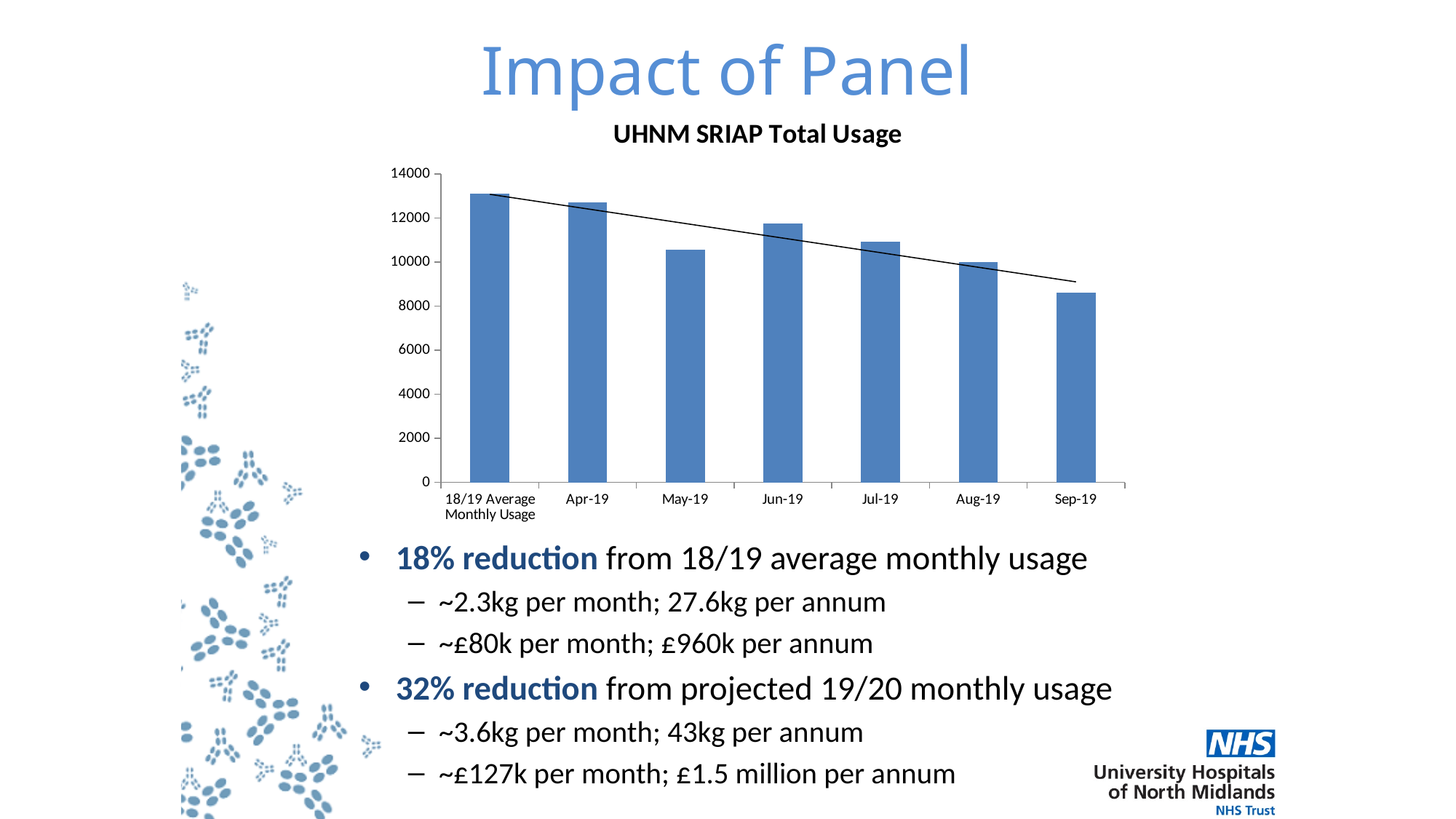
Which category has the highest bar? 18/19 Average Monthly Usage Which month has the lowest bar? Sep-19 Which is larger, the value for Apr-19 or the value for Sep-19? Apr-19 Is the value for Sep-19 greater or less than 10000? less Is the value for 18/19 Average Monthly Usage greater or less than 12000? greater Is the value for May-19 greater or less than 12000? less What kind of chart is shown on the slide? bar chart How many bars are plotted in the chart? 7 Do the values generally rise or fall from left to right across the chart? fall What is the title of the chart? UHNM SRIAP Total Usage Which is larger, the value for Jun-19 or the value for May-19? Jun-19